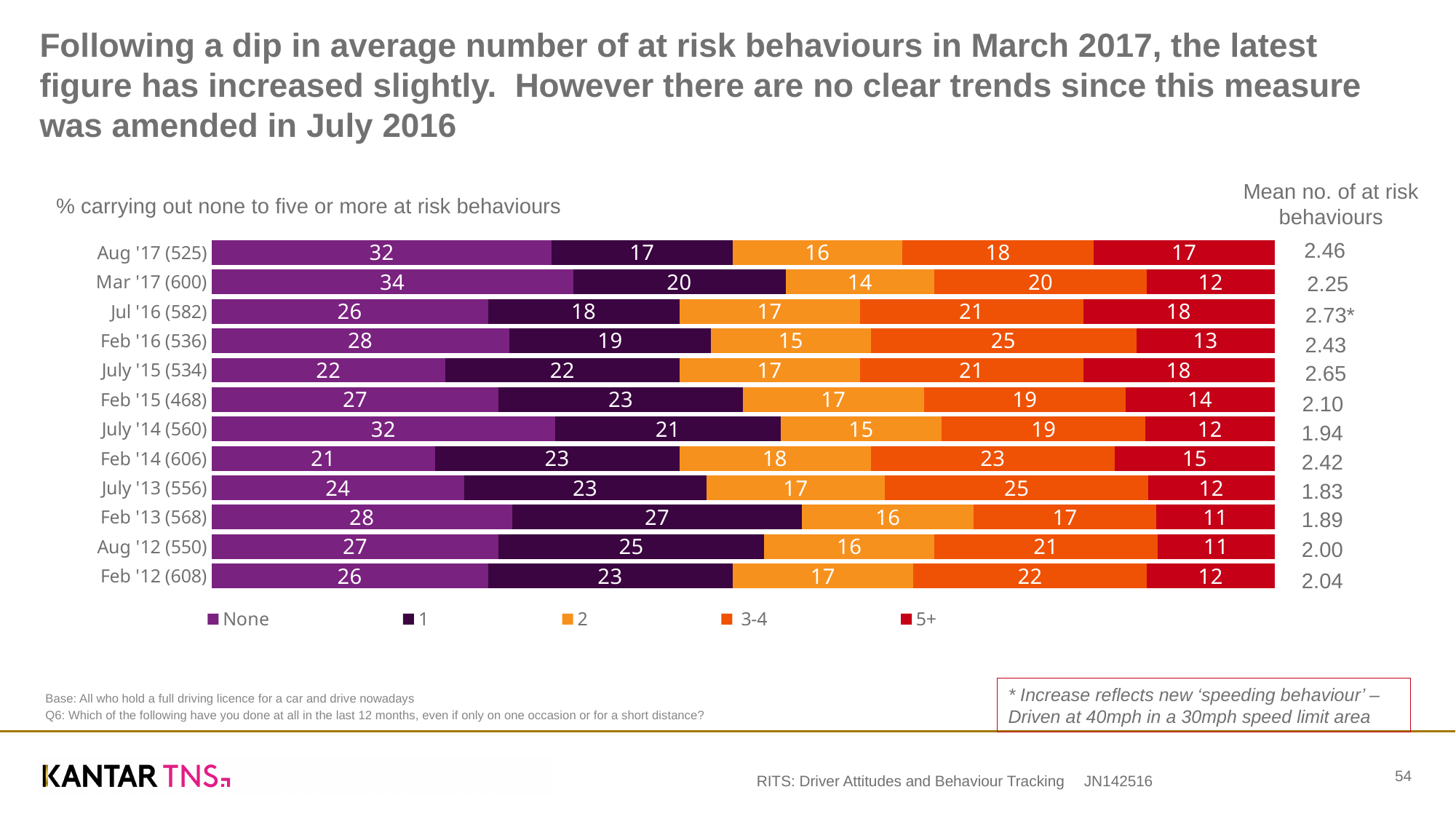
Which wave has the lowest 'None' percentage? Feb '14 (606) What is the mean number of at risk behaviours shown for Aug '17 (525)? 2.46 How many series does the legend list? 5 What percentage of drivers in the Aug '17 (525) wave carried out none of the at risk behaviours? 32 What is the total of the stacked bar for Jul '16 (582)? 100 What kind of chart is shown on the slide? Stacked bar chart Which wave has the lowest mean number of at risk behaviours? July '13 (556) Which is larger, the 5+ segment for Aug '17 (525) or for Mar '17 (600)? Aug '17 (525) How much larger is the 3-4 segment for Feb '16 (536) than for Feb '15 (468)? 6 Which wave has the highest 'None' percentage? Mar '17 (600) What is the value of the 5+ segment for Mar '17 (600)? 12 How many survey waves are shown in the chart? 12